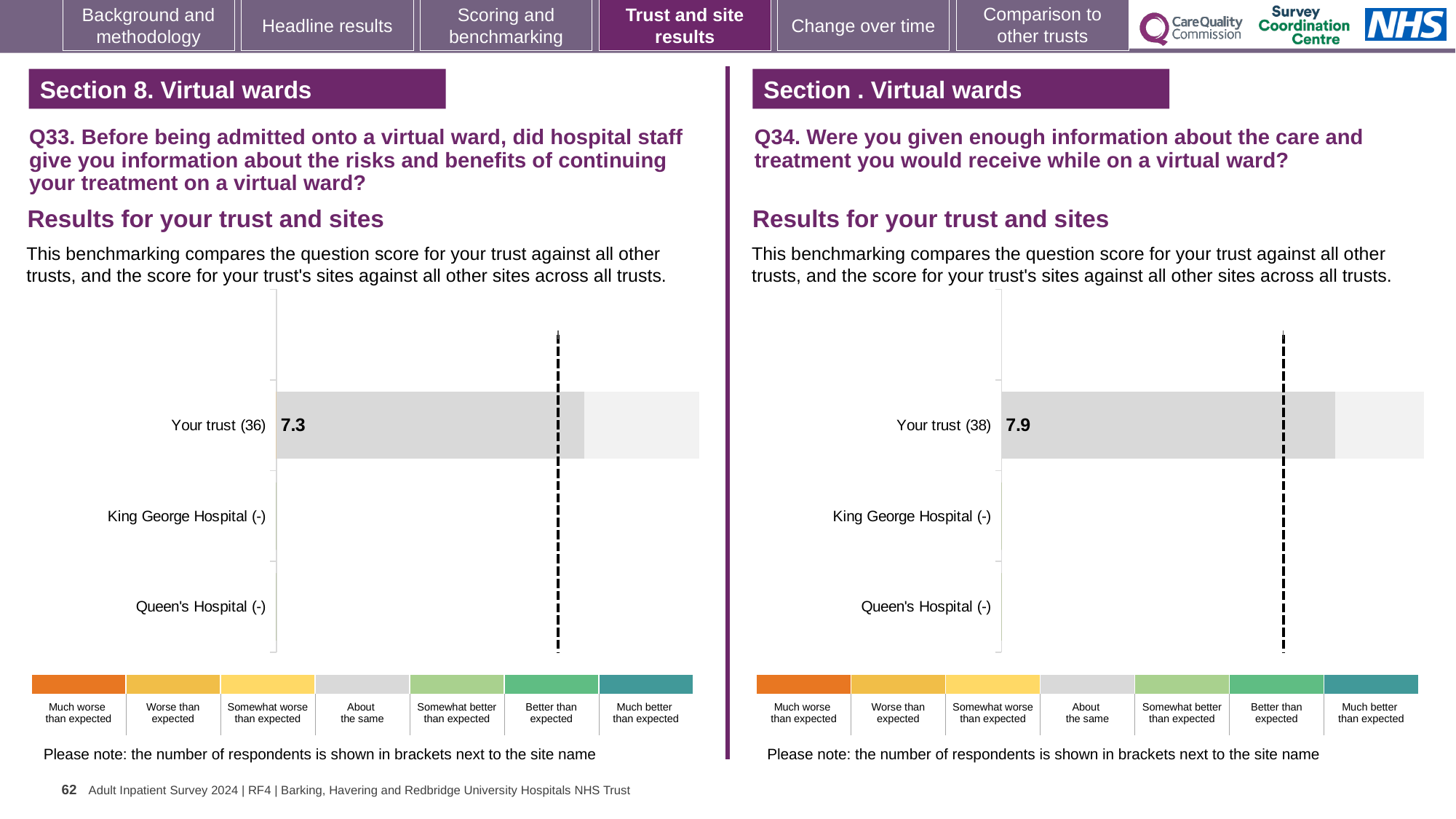
How many categories (rows) are listed in the Q34 chart on the right? 3 What kind of chart is used for the Q33 results on the left? Bar chart In the Q33 chart on the left, which category has the highest score shown? Your trust In the Q33 chart on the left, how many respondents are shown in brackets next to Your trust? 36 How many rating categories does the colour key below the Q34 chart on the right list? 7 In the Q33 chart on the left, which two sites have no score shown (marked with a dash)? King George Hospital and Queen's Hospital In the Q33 chart on the left, what is the score for Your trust? 7.3 How many categories (rows) are listed in the Q33 chart on the left? 3 In the Q34 chart on the right, what is the score for Your trust? 7.9 Which is larger: the Your trust score in the Q33 chart on the left or the Your trust score in the Q34 chart on the right? Q34 (7.9) What is the difference between the Your trust score in the Q34 chart on the right and the Your trust score in the Q33 chart on the left? 0.6 In the Q34 chart on the right, how many respondents are shown in brackets next to Your trust? 38